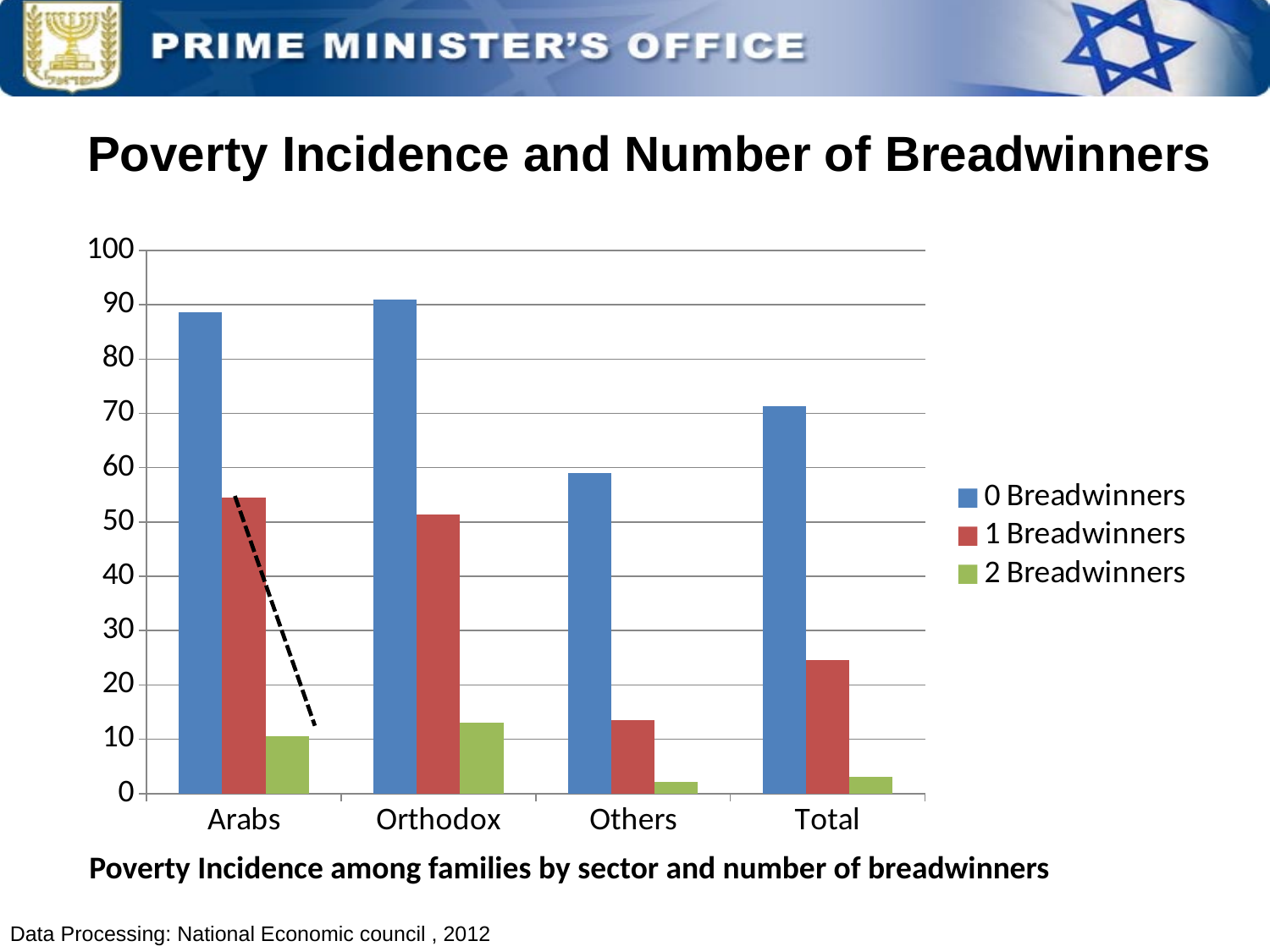
What is the caption printed below the chart? Poverty Incidence among families by sector and number of breadwinners Is the value for 1 Breadwinners in the Total category greater or less than 30? less How many series does the chart's legend list? 3 Which category has the lowest value for 1 Breadwinners? Others Which category has the highest value for 0 Breadwinners? Orthodox How many categories are shown on the x axis of the chart? 4 Is the value for 0 Breadwinners in the Total category greater or less than 60? greater Which category has the highest value for 2 Breadwinners? Orthodox What kind of chart is shown on the slide? bar chart Which is larger: the 0 Breadwinners value for Arabs or for Total? Arabs Is the value for 1 Breadwinners in the Others category greater or less than 20? less Which category has the lowest value for 0 Breadwinners? Others